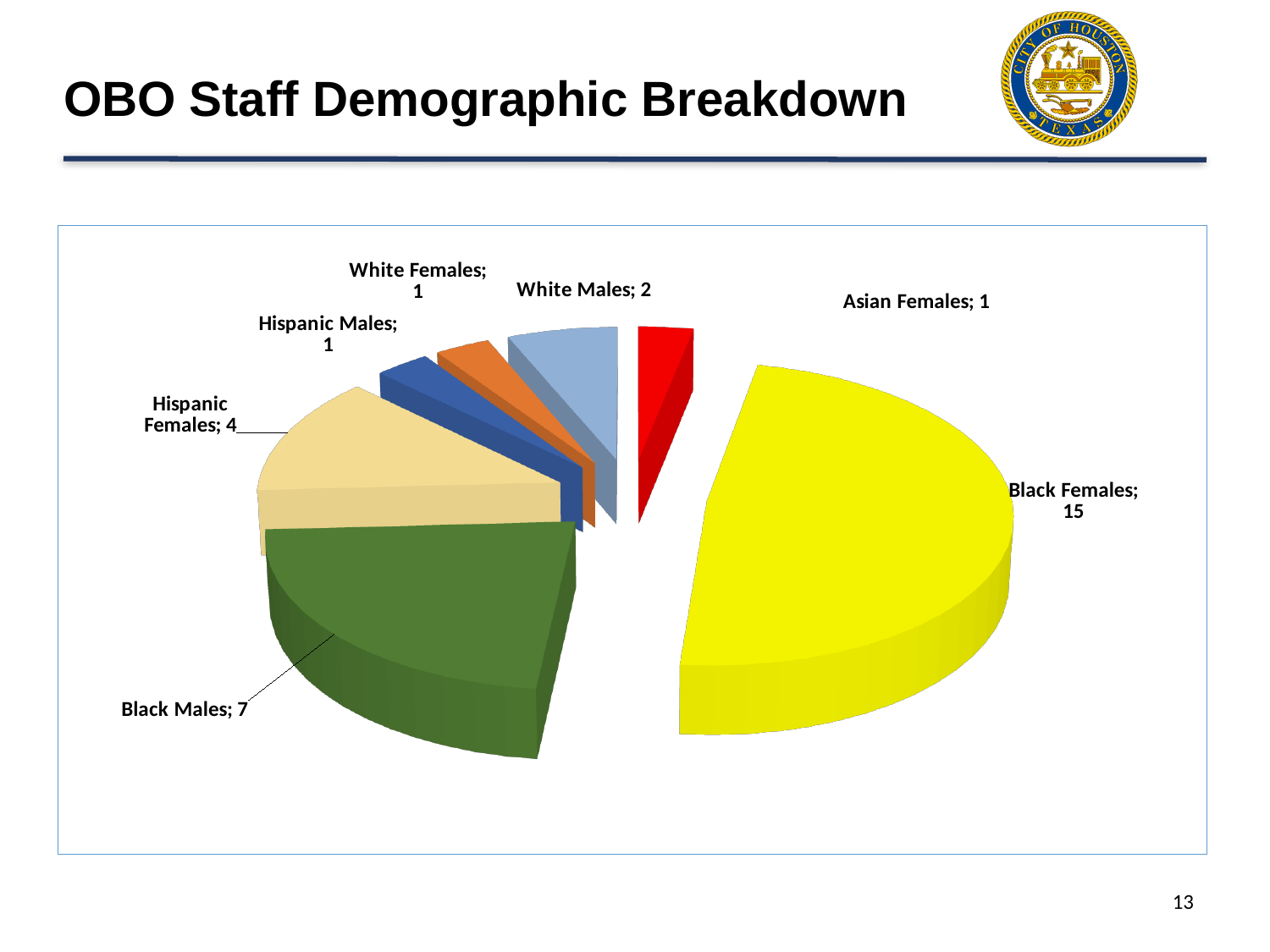
Which is larger, the value for Hispanic Females or the value for White Males? Hispanic Females How many demographic categories are shown in the pie chart? 7 What is the value shown for Black Males? 7 How many staff are Black Females according to the chart? 15 What is the title of the slide containing the chart? OBO Staff Demographic Breakdown What type of chart is shown on the slide? Pie chart What is the value shown for Hispanic Females? 4 What is the value shown for White Males? 2 What is the value shown for Asian Females? 1 What is the total number of staff represented across all slices of the pie? 31 Which demographic group has the largest slice of the pie? Black Females What is the difference between the number of Black Females and Black Males? 8